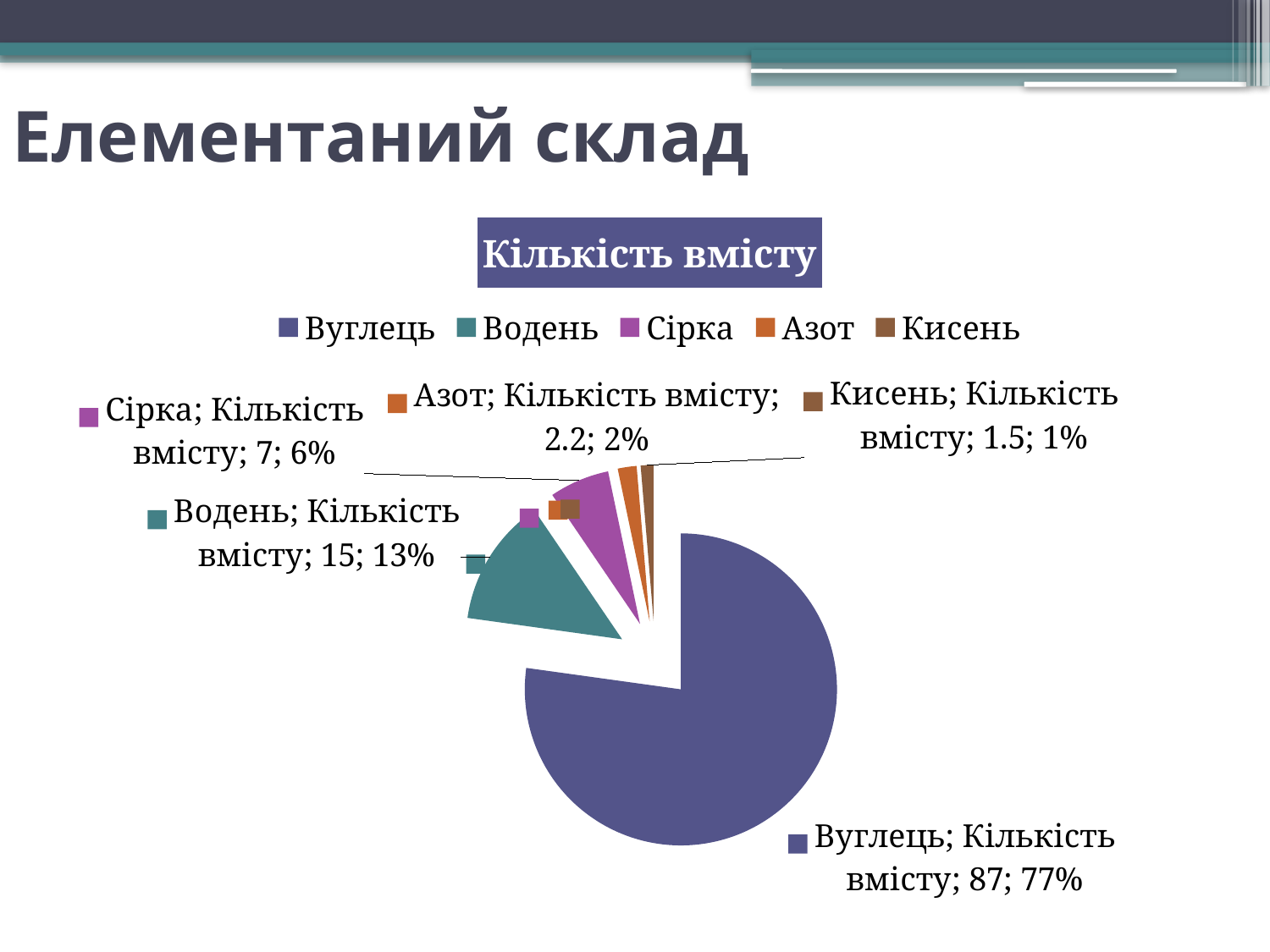
What is the difference between the values for Вуглець and Водень? 72 What is the title of the chart? Кількість вмісту Which category has the smallest slice? Кисень How many slices does the pie chart have? 5 What is the value for Азот? 2.2 What is the value for Кисень? 1.5 What is the value for Вуглець? 87 Which category has the largest slice? Вуглець What is the value for Водень? 15 What share of the pie does Вуглець represent? 77% What type of chart is shown on the slide? Pie chart What share of the pie does Сірка represent? 6%